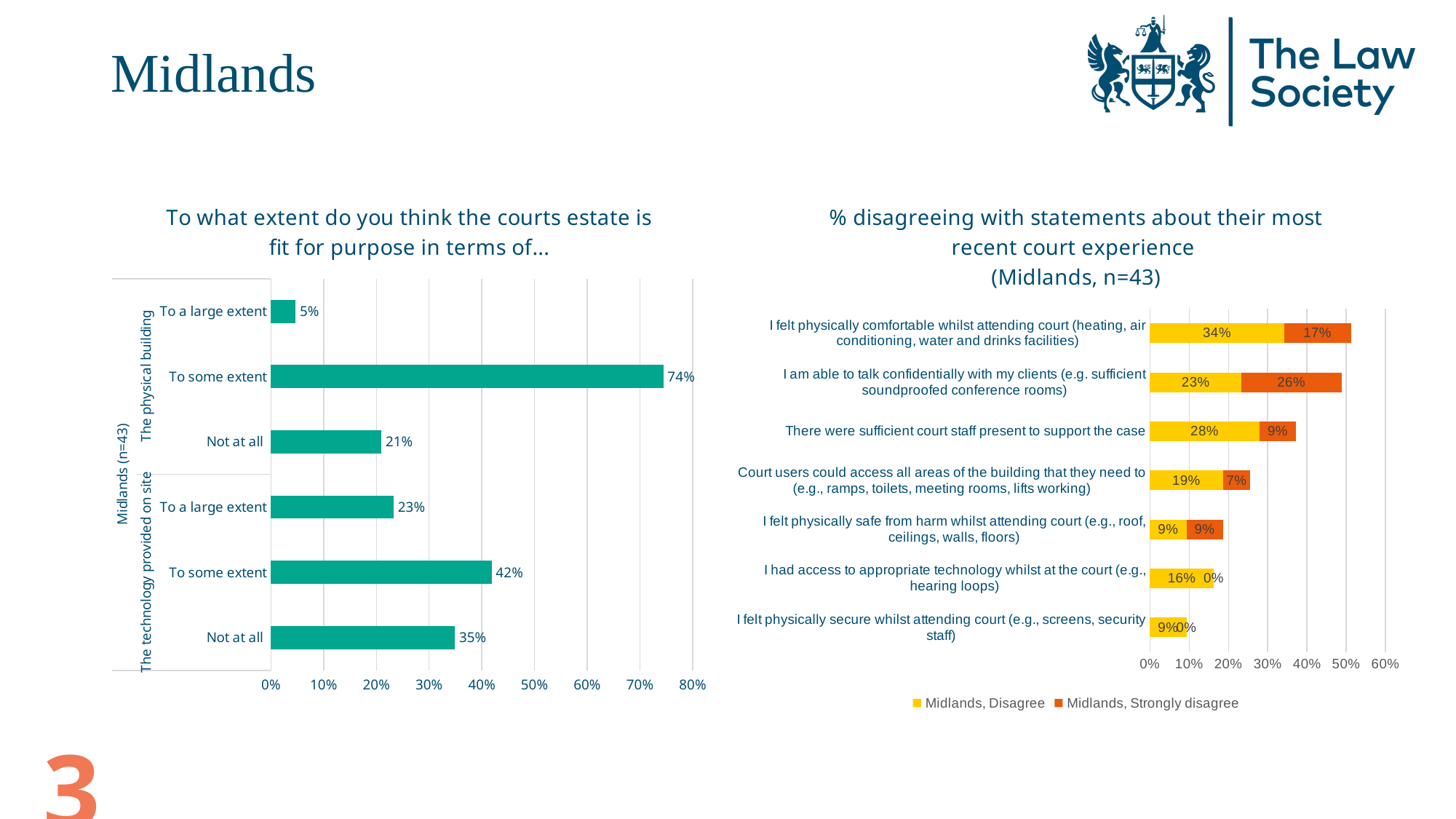
In the right chart ('% disagreeing with statements about their most recent court experience'), what is the 'Midlands, Strongly disagree' value for 'I am able to talk confidentially with my clients'? 26% In the right chart ('% disagreeing with statements about their most recent court experience'), what is the total of the stacked bar for 'I felt physically comfortable whilst attending court'? 51% In the left chart ('To what extent do you think the courts estate is fit for purpose in terms of...'), how many bars are plotted? 6 In the right chart ('% disagreeing with statements about their most recent court experience'), which statement has the highest 'Midlands, Disagree' value? I felt physically comfortable whilst attending court (heating, air conditioning, water and drinks facilities) In the left chart ('To what extent do you think the courts estate is fit for purpose in terms of...'), which category has the lowest value? To a large extent (The physical building) In the left chart ('To what extent do you think the courts estate is fit for purpose in terms of...'), which is larger: 'Not at all' for the physical building or 'Not at all' for the technology provided on site? Not at all for the technology provided on site In the left chart ('To what extent do you think the courts estate is fit for purpose in terms of...'), what is the value for 'Not at all' under 'The technology provided on site'? 35% In the right chart ('% disagreeing with statements about their most recent court experience'), what colour represents 'Midlands, Strongly disagree'? Orange What type of chart is the left chart ('To what extent do you think the courts estate is fit for purpose in terms of...')? Bar chart In the right chart ('% disagreeing with statements about their most recent court experience'), how many series does the legend list? 2 In the left chart ('To what extent do you think the courts estate is fit for purpose in terms of...'), what is the difference between 'To some extent' for the physical building and 'To some extent' for the technology provided on site? 32% In the left chart ('To what extent do you think the courts estate is fit for purpose in terms of...'), what is the value for 'To some extent' under 'The physical building'? 74%